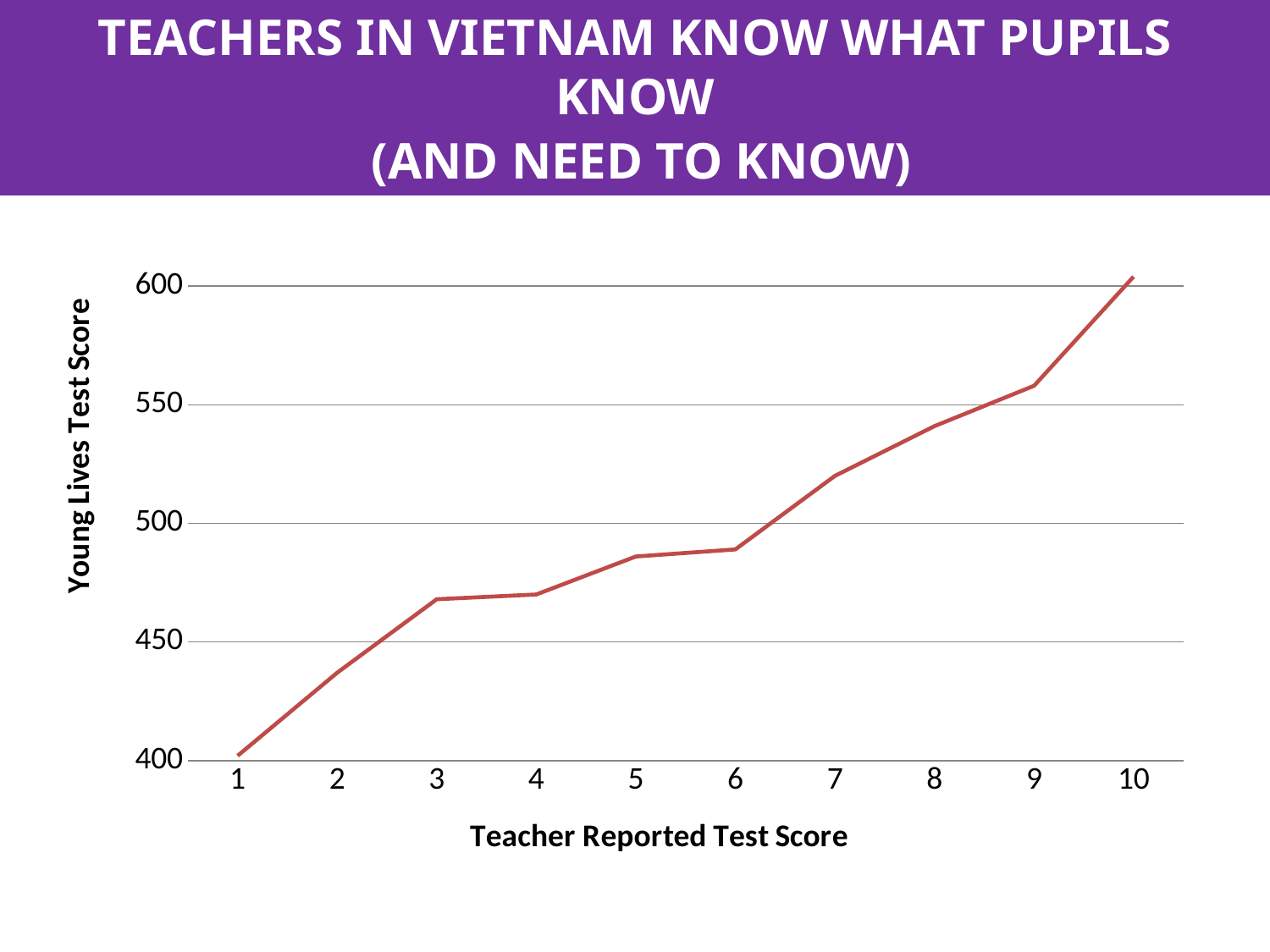
What is the label of the y axis? Young Lives Test Score Is the Young Lives Test Score for a Teacher Reported Test Score of 9 greater or less than 550? greater Is the Young Lives Test Score for a Teacher Reported Test Score of 2 greater or less than 450? less Is the Young Lives Test Score for a Teacher Reported Test Score of 7 greater or less than 500? greater Which has the higher Young Lives Test Score: a Teacher Reported Test Score of 3 or of 8? 8 Do the Young Lives Test Score values rise or fall as the Teacher Reported Test Score increases from 1 to 10? Rise At which Teacher Reported Test Score is the Young Lives Test Score highest? 10 What kind of chart is shown on the slide? Line chart What is the label of the x axis? Teacher Reported Test Score At which Teacher Reported Test Score is the Young Lives Test Score lowest? 1 How many Teacher Reported Test Score points are plotted along the x axis? 10